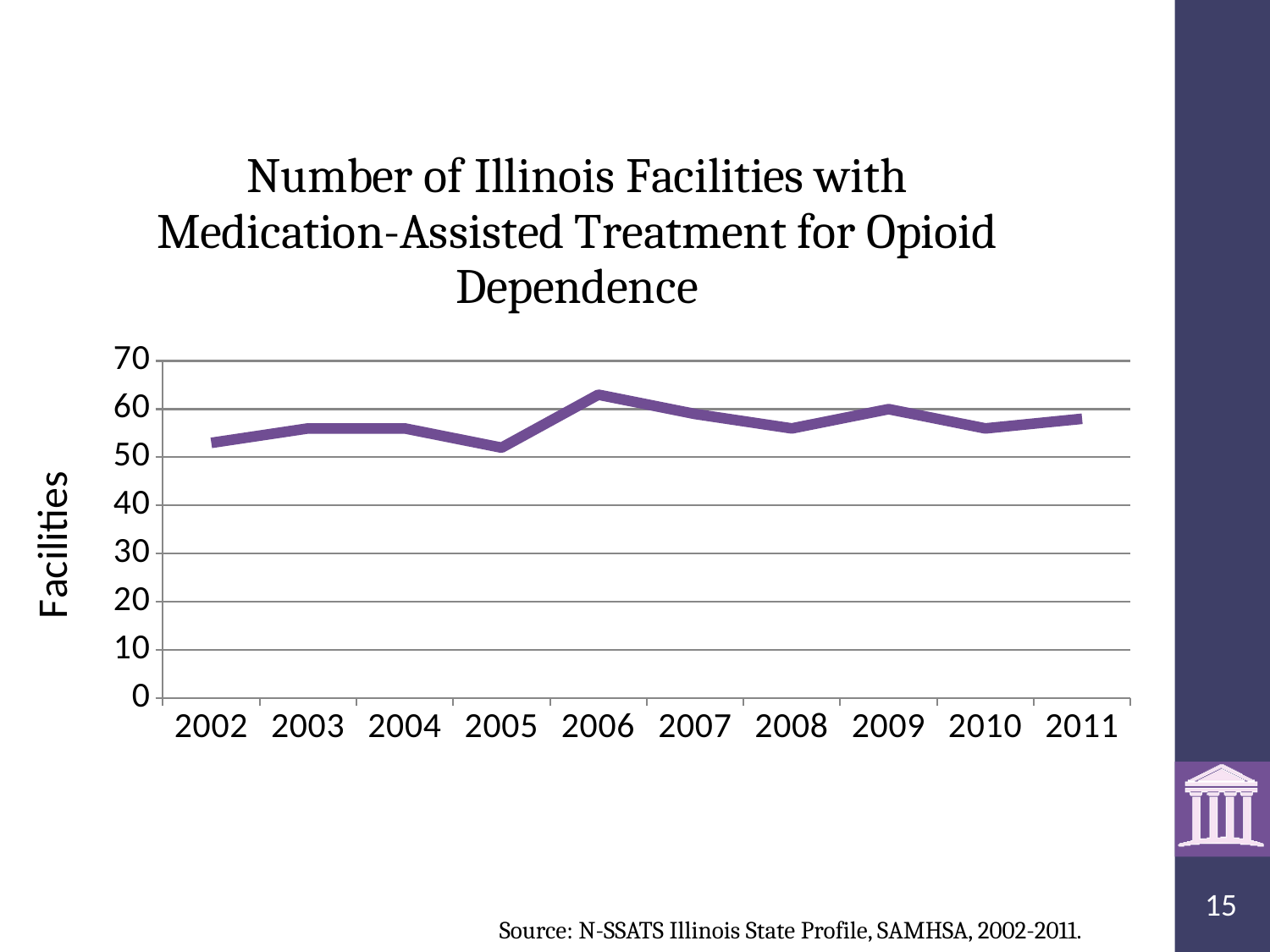
Which year has the larger value, 2003 or 2005? 2003 Does the number of facilities rise or fall from 2005 to 2006? rise Does the number of facilities rise or fall from 2006 to 2008? fall Is the value for 2002 greater or less than 50? greater In which year was the number of facilities highest? 2006 How many years are plotted along the x axis? 10 Is the value for 2006 greater or less than 60? greater Is the value for 2008 greater or less than 60? less What is the label on the y axis? Facilities Which year has the larger value, 2005 or 2006? 2006 What kind of chart is shown on the slide? line chart